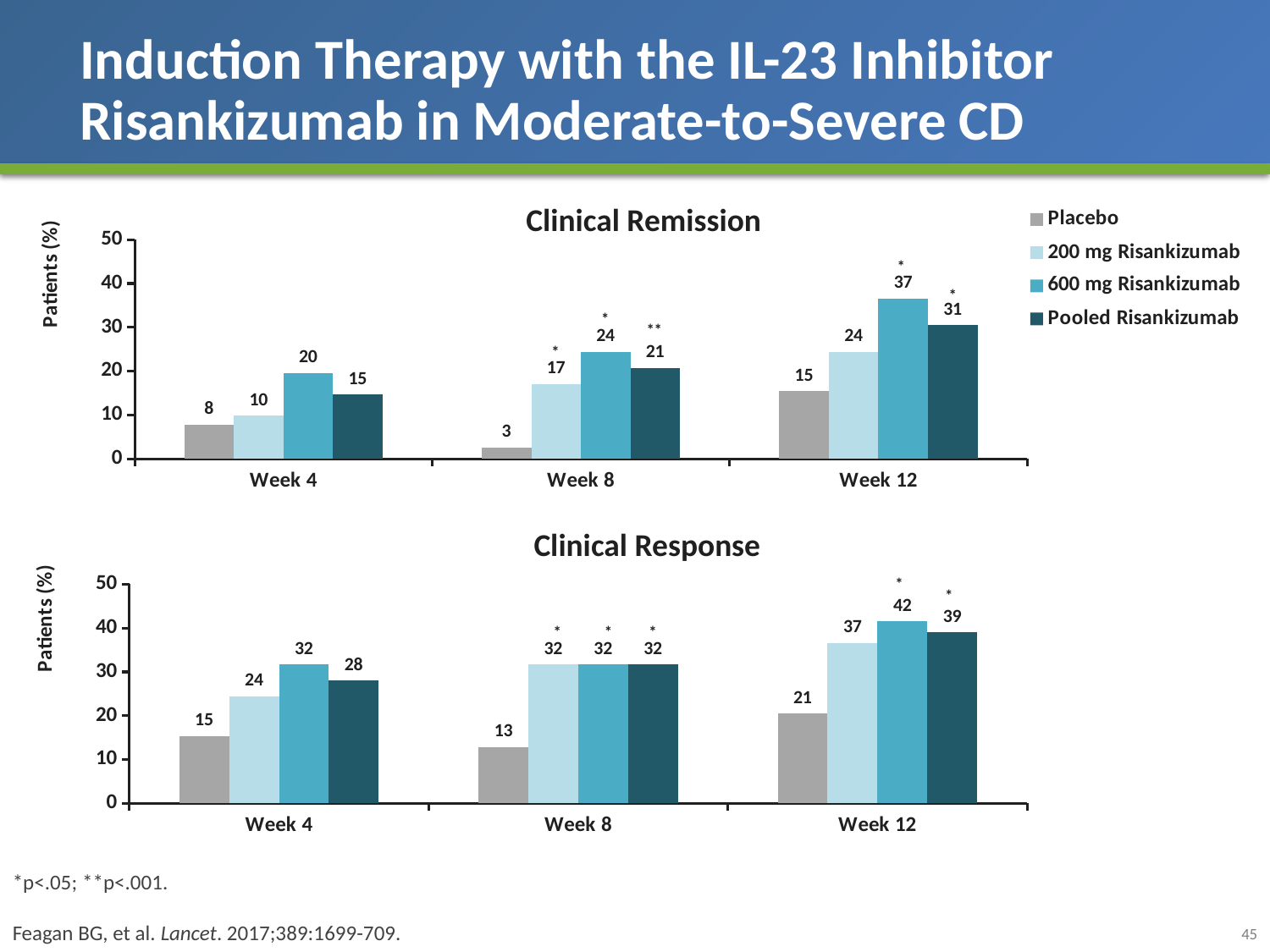
In the Clinical Remission chart, does the value for 600 mg Risankizumab rise or fall from Week 4 to Week 12? Rise What kind of chart is the Clinical Remission chart? Bar chart In the Clinical Response chart, what is the value for Pooled Risankizumab at Week 12? 39 In the Clinical Response chart, what is the value for Placebo at Week 4? 15 How many time-point categories are shown on the x axis of the Clinical Response chart? 3 How many series does the legend list? 4 In the Clinical Remission chart, which series has the highest value at Week 12? 600 mg Risankizumab In the Clinical Remission chart, what is the difference between 600 mg Risankizumab and Placebo at Week 12? 22 In the Clinical Response chart, which is larger at Week 4: 200 mg Risankizumab or Pooled Risankizumab? Pooled Risankizumab In the Clinical Response chart, which series has the lowest value at Week 8? Placebo In the Clinical Remission chart, what is the value for 600 mg Risankizumab at Week 12? 37 In the Clinical Remission chart, what is the value for Placebo at Week 8? 3